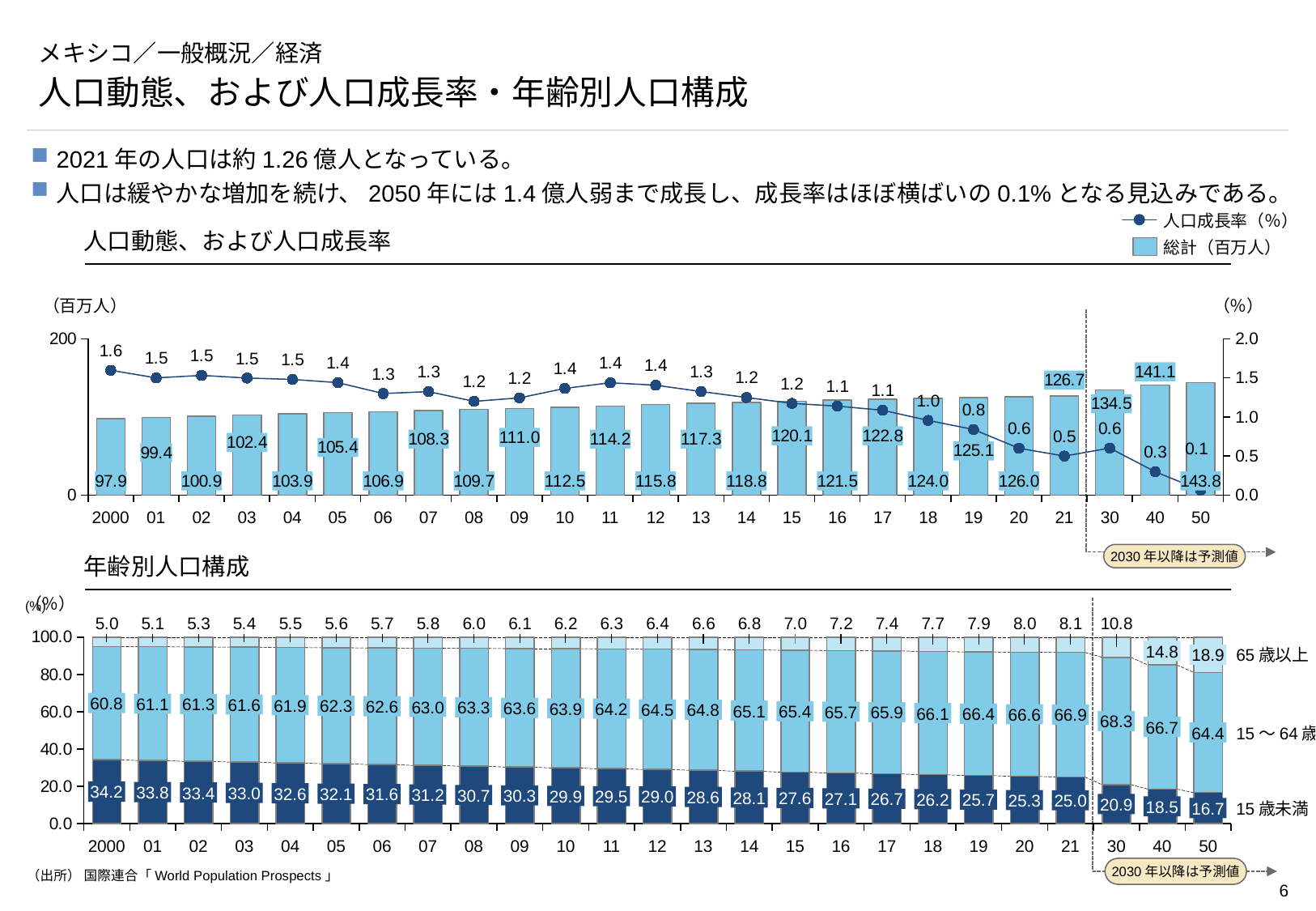
In the bottom chart 「年齢別人口構成」, which is larger in 2040: the share of 15 歳未満 or the share of 65 歳以上? 15 歳未満 In the top chart 「人口動態、および人口成長率」, how many series does the legend list? 2 In the top chart 「人口動態、および人口成長率」, what is the difference between the total population in 2050 and in 2000? 45.9 What kind of chart is the bottom chart 「年齢別人口構成」? stacked bar chart In the bottom chart 「年齢別人口構成」, what is the share of 65 歳以上 in 2050? 18.9 In the top chart 「人口動態、および人口成長率」, does the population growth rate line generally rise or fall from 2000 to 2050? fall In the top chart 「人口動態、および人口成長率」, what is the population growth rate (人口成長率) for 2000? 1.6 In the top chart 「人口動態、および人口成長率」, which year has the lowest population growth rate? 50 In the bottom chart 「年齢別人口構成」, which year has the highest share of 15 ～ 64 歳? 30 In the top chart 「人口動態、および人口成長率」, what is the total population (総計) value for 2021? 126.7 In the bottom chart 「年齢別人口構成」, what is the share of 15 歳未満 in 2000? 34.2 In the top chart 「人口動態、および人口成長率」, which year has the highest total population bar? 50